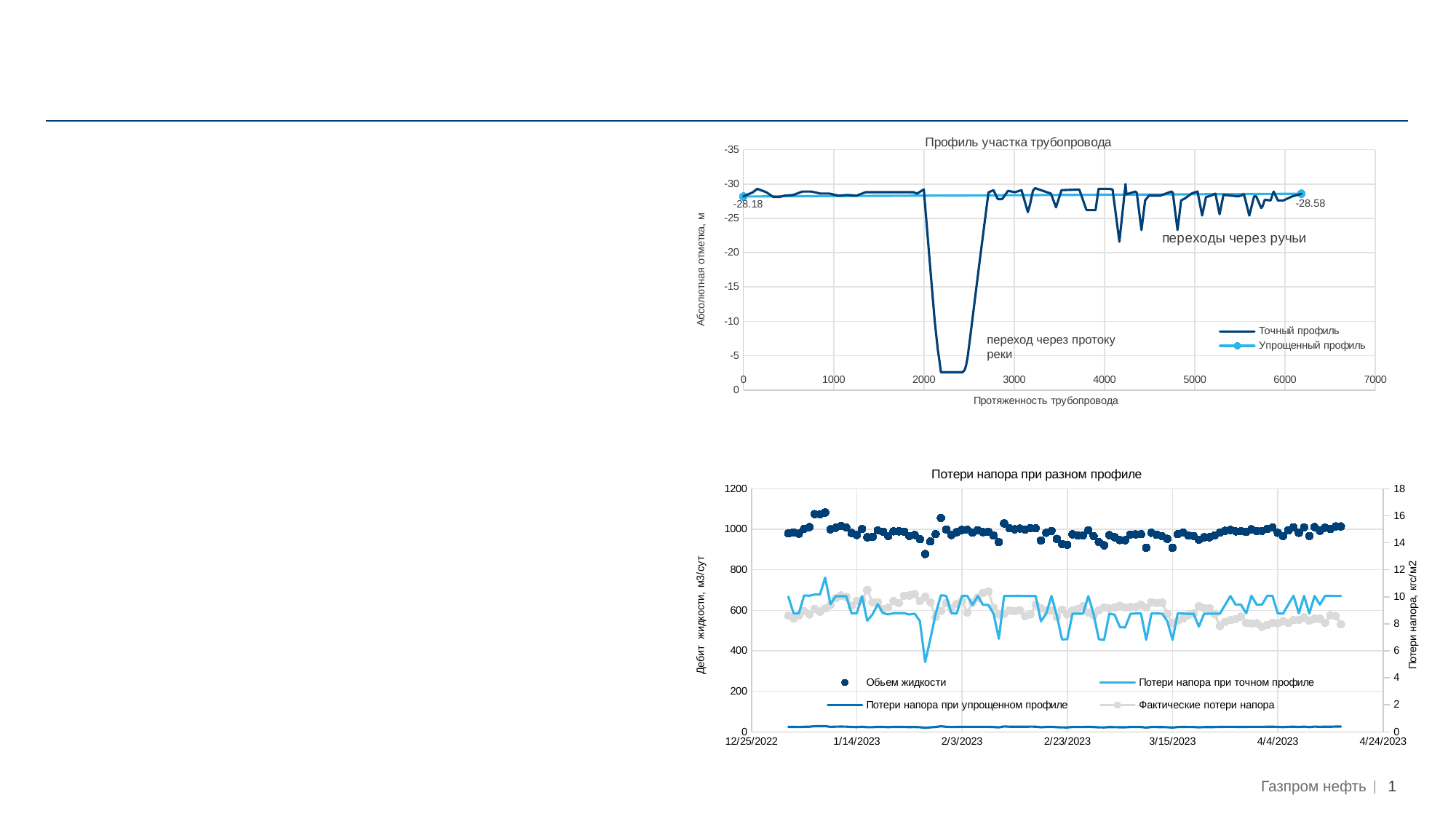
In the bottom chart, is the value for Обьем жидкости on 2/3/2023 greater or less than 800? greater In the top chart, how many series does the legend list? 2 What is the title of the bottom chart? Потери напора при разном профиле In the top chart, which labeled value of Упрощенный профиль is larger, the one at the start (-28.18) or the one at the end (-28.58)? -28.18 What kind of chart is the top chart (Профиль участка трубопровода)? line chart In the top chart, is the value of Точный профиль at about 2200 m greater or less than -10? greater In the top chart, what is the labeled value of Упрощенный профиль at the start of the pipeline (x = 0)? -28.18 In the bottom chart, is the value for Потери напора при упрощенном профиле on 3/15/2023 greater or less than 200 on the left axis? less What is the title of the top chart? Профиль участка трубопровода In the bottom chart, how many series does the legend list? 4 In the top chart, what is the labeled value of Упрощенный профиль at the end of the pipeline (near x = 6200)? -28.58 In the top chart, what is the difference between the two labeled values of Упрощенный профиль, -28.18 and -28.58? 0.4